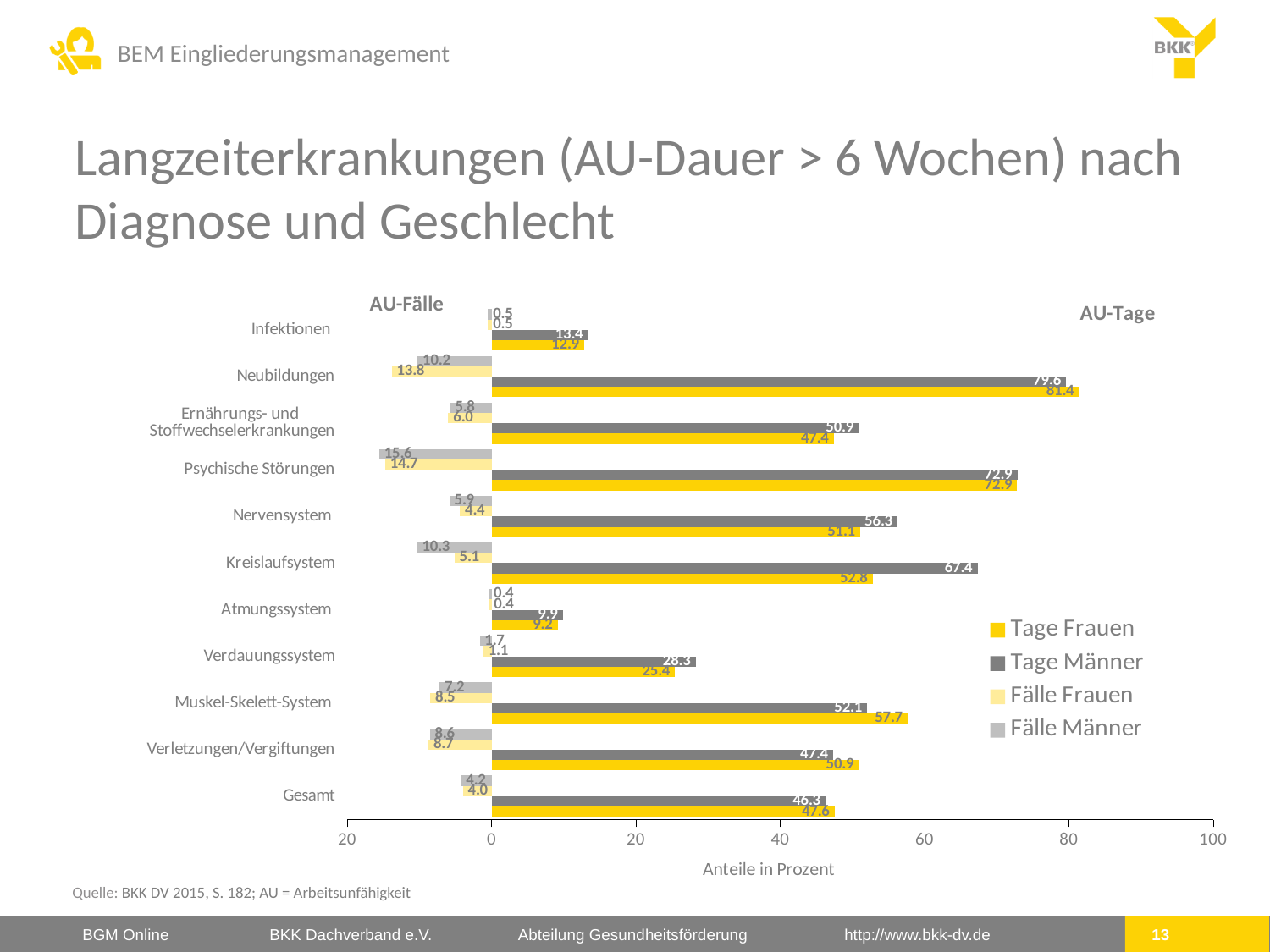
How many series does the legend list? 4 What kind of chart is shown on the slide? Bar chart Which diagnosis has the highest Tage Frauen value? Neubildungen Which is larger for Muskel-Skelett-System: Tage Frauen or Tage Männer? Tage Frauen Which diagnosis has the lowest Tage Männer value? Atmungssystem What is the value of Fälle Frauen for Muskel-Skelett-System? 8.5 What is the x-axis label of the chart? Anteile in Prozent What is the difference between Tage Männer and Tage Frauen for Kreislaufsystem? 14.6 What is the value of Tage Frauen for Neubildungen? 81.4 How many diagnosis categories are shown on the chart? 11 What is the value of Tage Männer for Kreislaufsystem? 67.4 What is the value of Fälle Männer for Psychische Störungen? 15.6